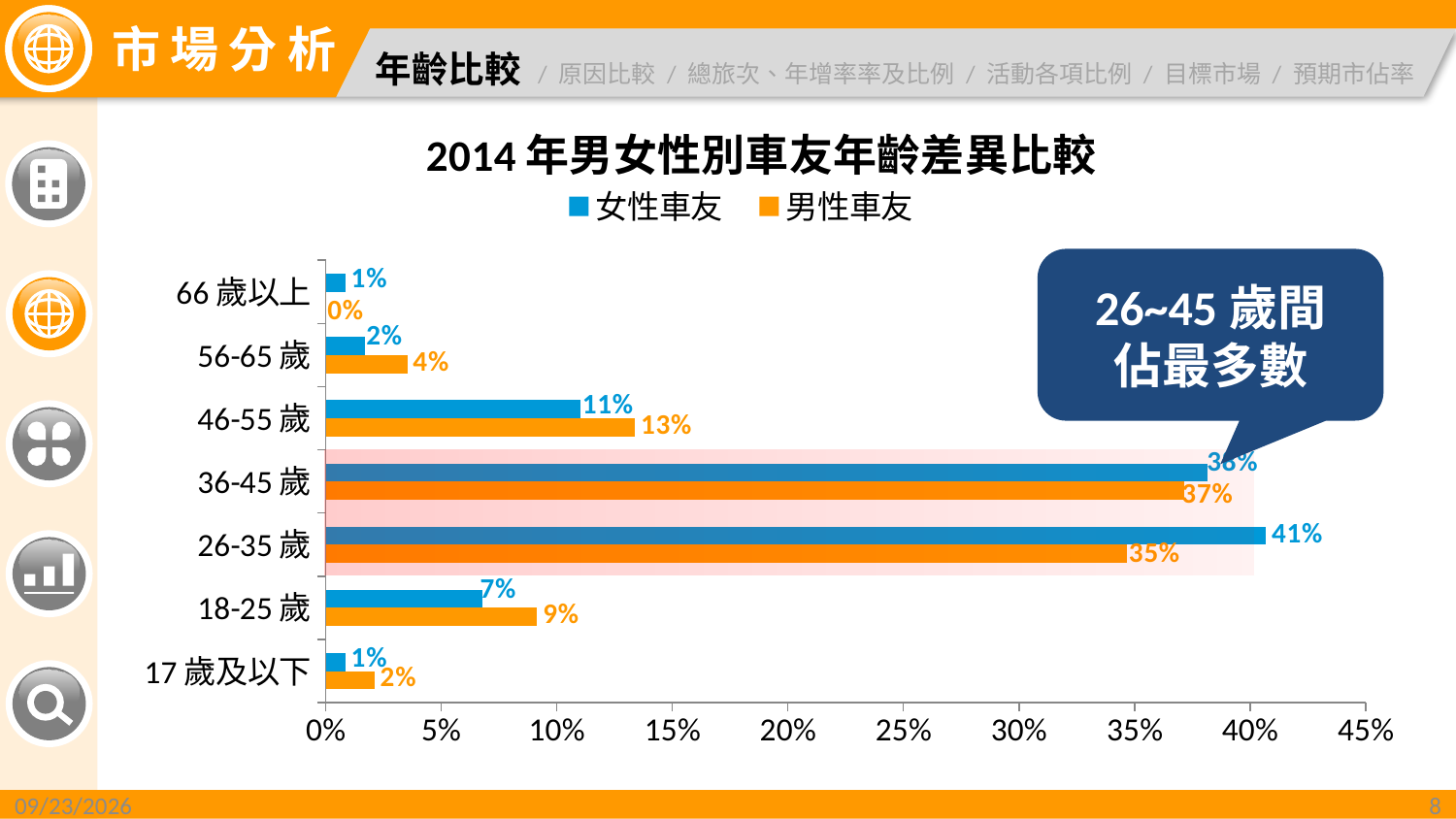
What is the title of the chart? 2014 年男女性別車友年齡差異比較 What is the value for 男性車友 in the 46-55 歲 category? 13% In the 18-25 歲 category, which is larger: 女性車友 or 男性車友? 男性車友 What is the value for 女性車友 in the 26-35 歲 category? 41% What kind of chart is shown on the slide? Bar chart Is the value for 女性車友 in the 36-45 歲 category greater or less than 30%? greater How many series does the legend list? 2 What is the value for 男性車友 in the 36-45 歲 category? 37% What is the difference between 女性車友 and 男性車友 in the 26-35 歲 category? 6% Which age category has the lowest value for 男性車友? 66 歲以上 How many age categories are shown on the chart? 7 Which age category has the highest value for 女性車友? 26-35 歲